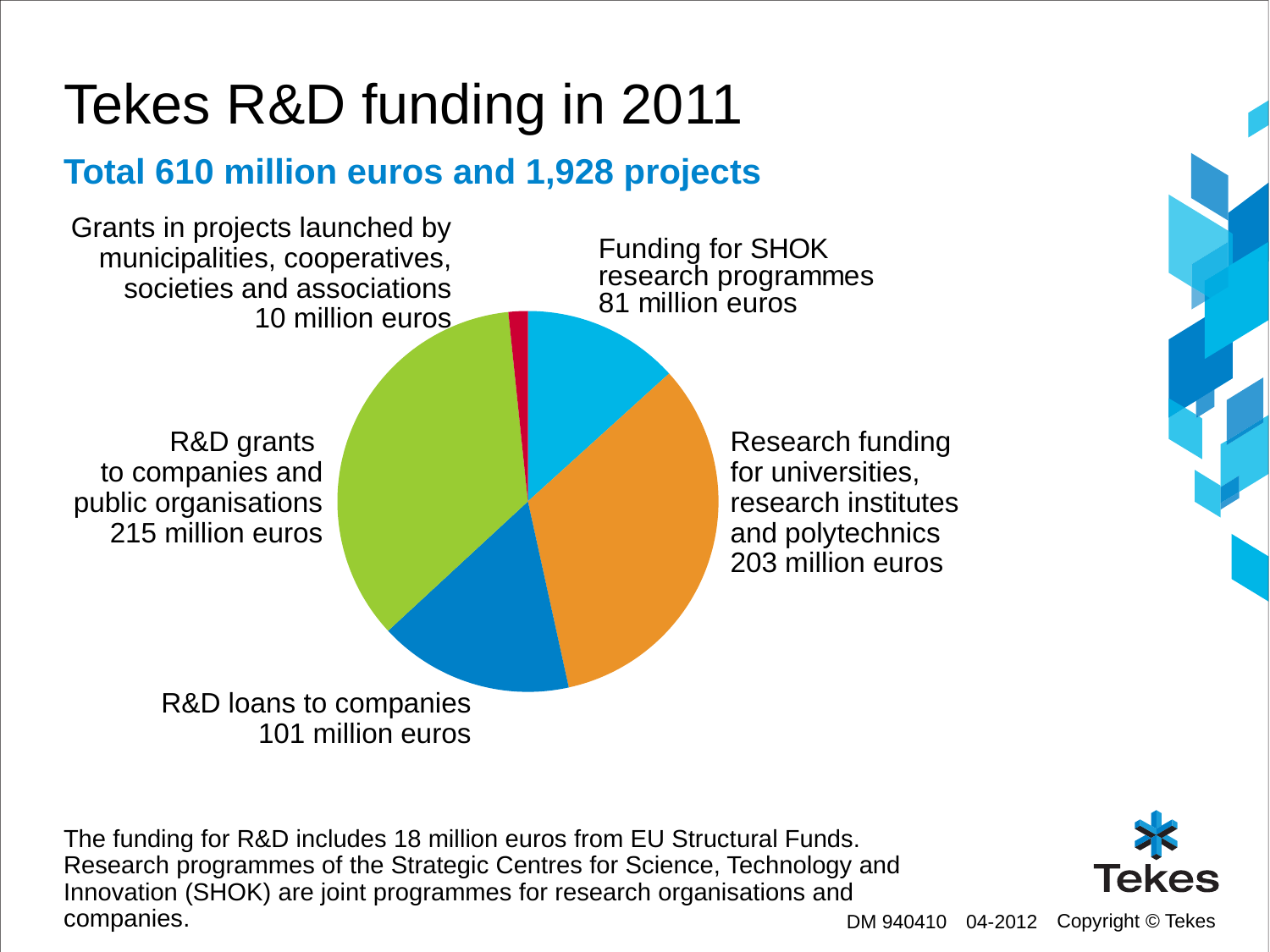
Which category received the smallest amount of funding? Grants in projects launched by municipalities, cooperatives, societies and associations Which category received the largest amount of funding? R&D grants to companies and public organisations How many slices does the pie chart have? 5 What is the total R&D funding shown on the slide? 610 million euros What is the difference between R&D grants to companies and public organisations and R&D loans to companies? 114 million euros How much funding went to research funding for universities, research institutes and polytechnics? 203 million euros What colour is the slice for R&D grants to companies and public organisations? Green Which is larger: funding for SHOK research programmes or R&D loans to companies? R&D loans to companies What type of chart is shown on the slide? Pie chart How much funding went to R&D grants to companies and public organisations? 215 million euros How much funding went to SHOK research programmes? 81 million euros How much funding went to R&D loans to companies? 101 million euros